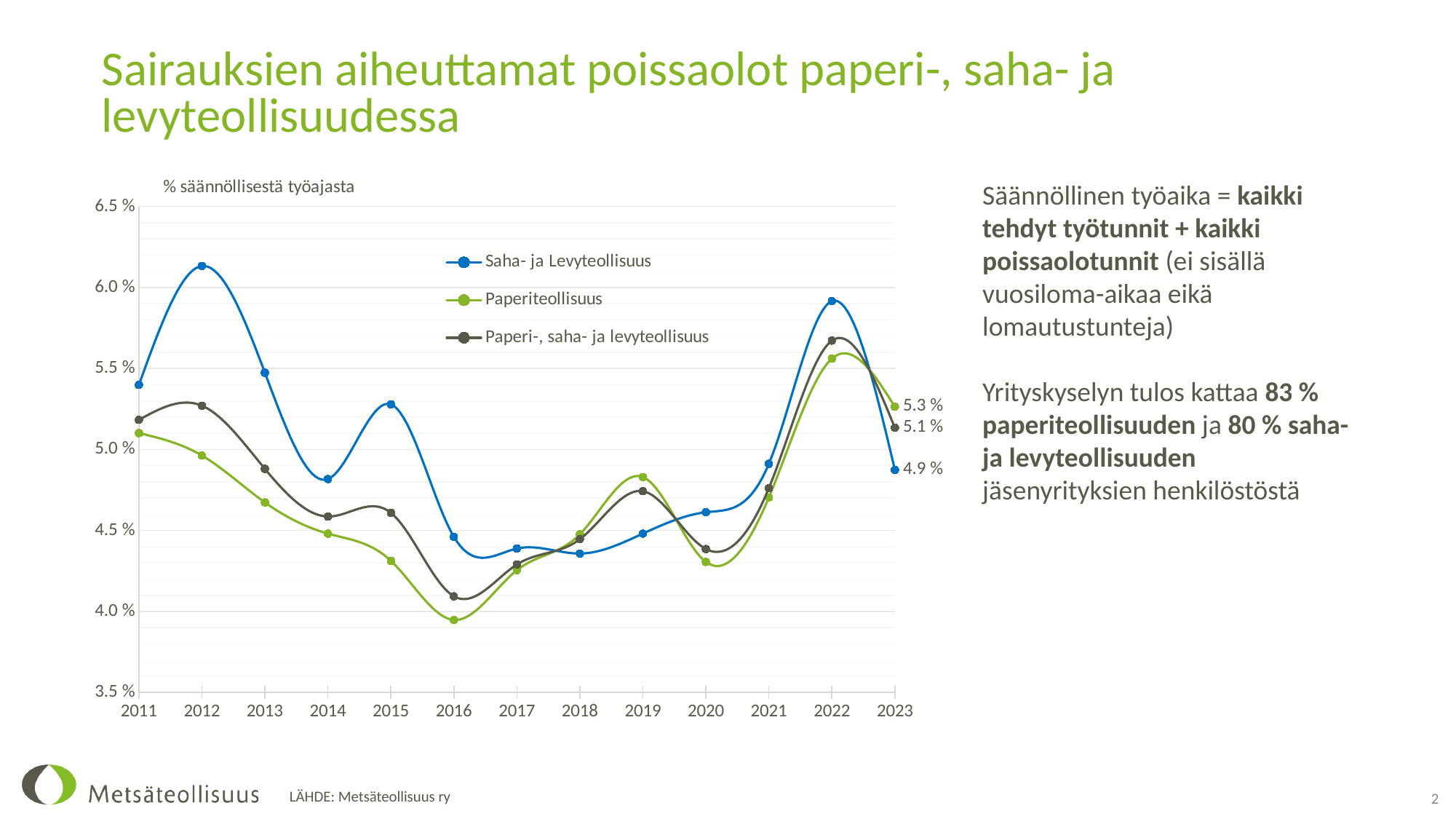
What is the value for Paperiteollisuus in 2023? 5.3 % What is the value for Saha- ja Levyteollisuus in 2023? 4.9 % Is the value for Saha- ja Levyteollisuus in 2014 greater or less than 5.0 %? less What is the value for Paperi-, saha- ja levyteollisuus in 2023? 5.1 % In which year does the Paperiteollisuus series reach its lowest value? 2016 Is the value for Saha- ja Levyteollisuus in 2012 greater or less than 6.0 %? greater How many series does the legend list? 3 What kind of chart is shown on the slide? line chart How many years are shown on the x axis? 13 In 2023, what is the difference between the Paperiteollisuus value and the Saha- ja Levyteollisuus value? 0.4 % In 2023, which is larger: Paperiteollisuus or Saha- ja Levyteollisuus? Paperiteollisuus In which year does the Saha- ja Levyteollisuus series reach its highest value? 2012